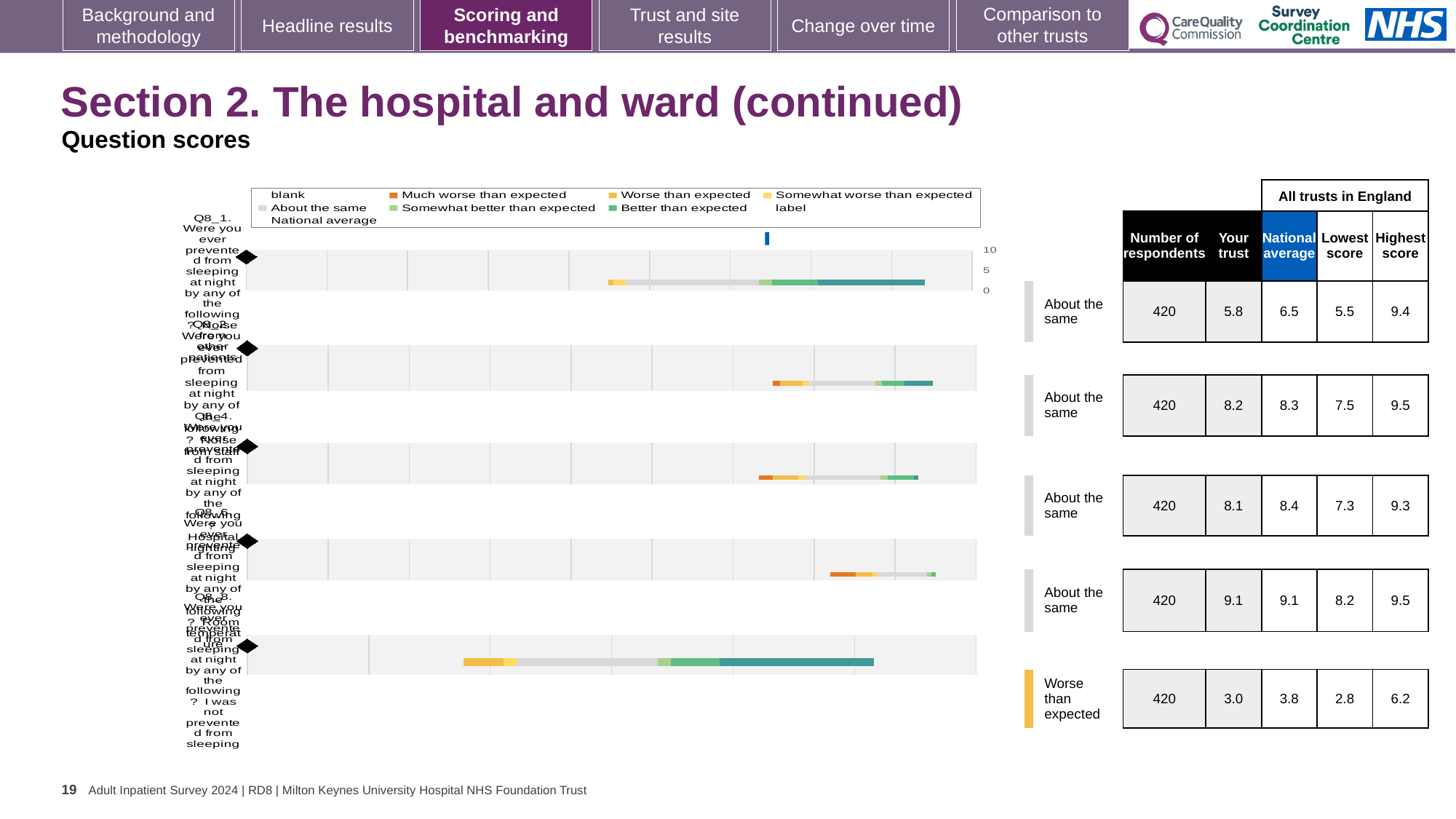
What benchmark label is printed beside the bottom (fifth) chart row? Worse than expected Which row in the table has the lowest 'Your trust' score? The bottom (fifth) row, 3.0 What kind of chart is used to show the question scores on this slide? Bar chart For the bottom (fifth) row, what is the difference between the 'National average' (3.8) and the 'Your trust' score (3.0)? 0.8 In the table beside the charts, what is the 'National average' for the bottom (fifth) row? 3.8 For the bottom (fifth) row, which is larger: the 'Your trust' score or the 'National average'? National average How many entries does the chart legend list? 9 Which legend entry is shown in grey? About the same In the table beside the charts, how many respondents are listed for the second row? 420 How many separate horizontal bar chart rows are plotted on the slide? 5 In the table beside the charts, what is the 'Your trust' score for the bottom (fifth) row? 3.0 In the table beside the charts, what is the 'Highest score' for the first (top) row? 9.4